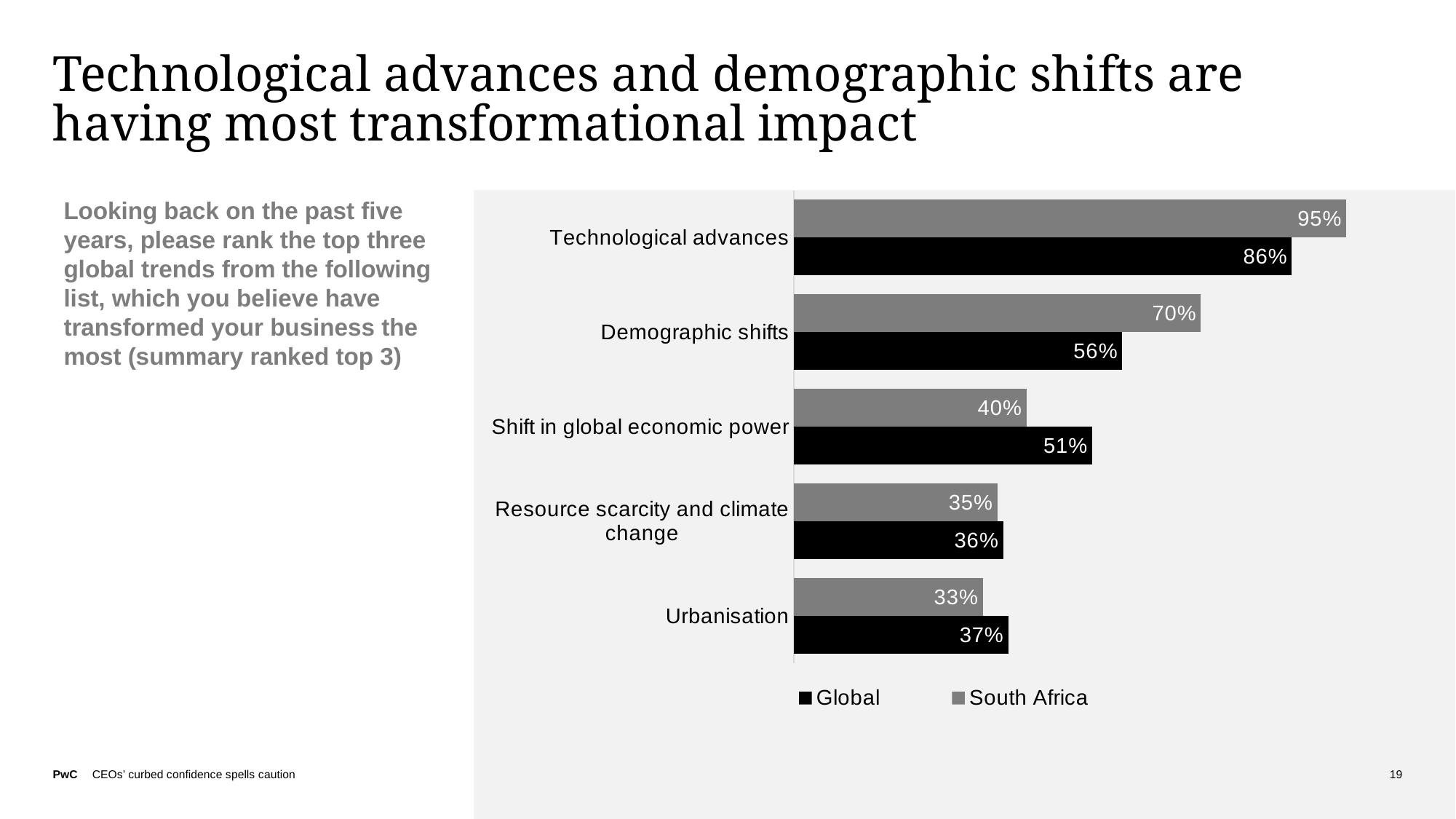
What is the Global value for Shift in global economic power? 51% What is the difference between the South Africa and Global values for Demographic shifts? 14% For Shift in global economic power, which is larger: the Global value or the South Africa value? Global Which series is shown in black in the legend? Global What kind of chart is shown on the slide? Bar chart What is the Global value for Demographic shifts? 56% How many categories are shown on the chart? 5 Which category has the lowest South Africa value? Urbanisation What is the South Africa value for Urbanisation? 33% Which category has the highest Global value? Technological advances What is the South Africa value for Technological advances? 95% How many series does the legend list? 2